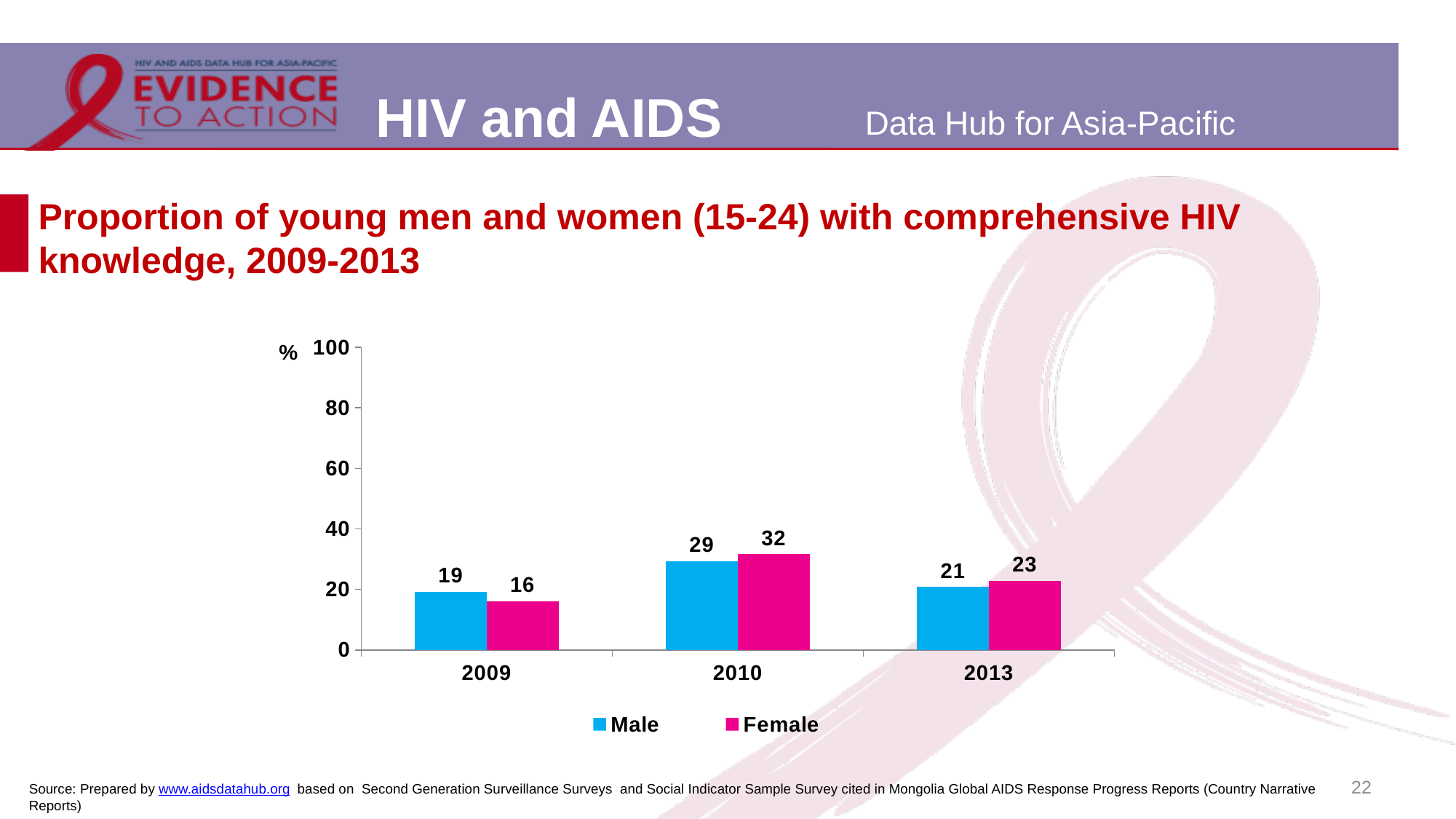
What is the value for Female in 2013? 23 What is the value for Female in 2010? 32 What is the value for Male in 2009? 19 What kind of chart is shown on the slide? bar chart In which year is the Male value highest? 2010 Which is larger in 2009, the Male value or the Female value? Male In which year is the Female value lowest? 2009 What colour are the Female bars? pink Is the value for Female in 2010 greater or less than 40? less What is the difference between the Female and Male values in 2010? 3 How many series does the legend list? 2 How many years are shown on the x axis? 3